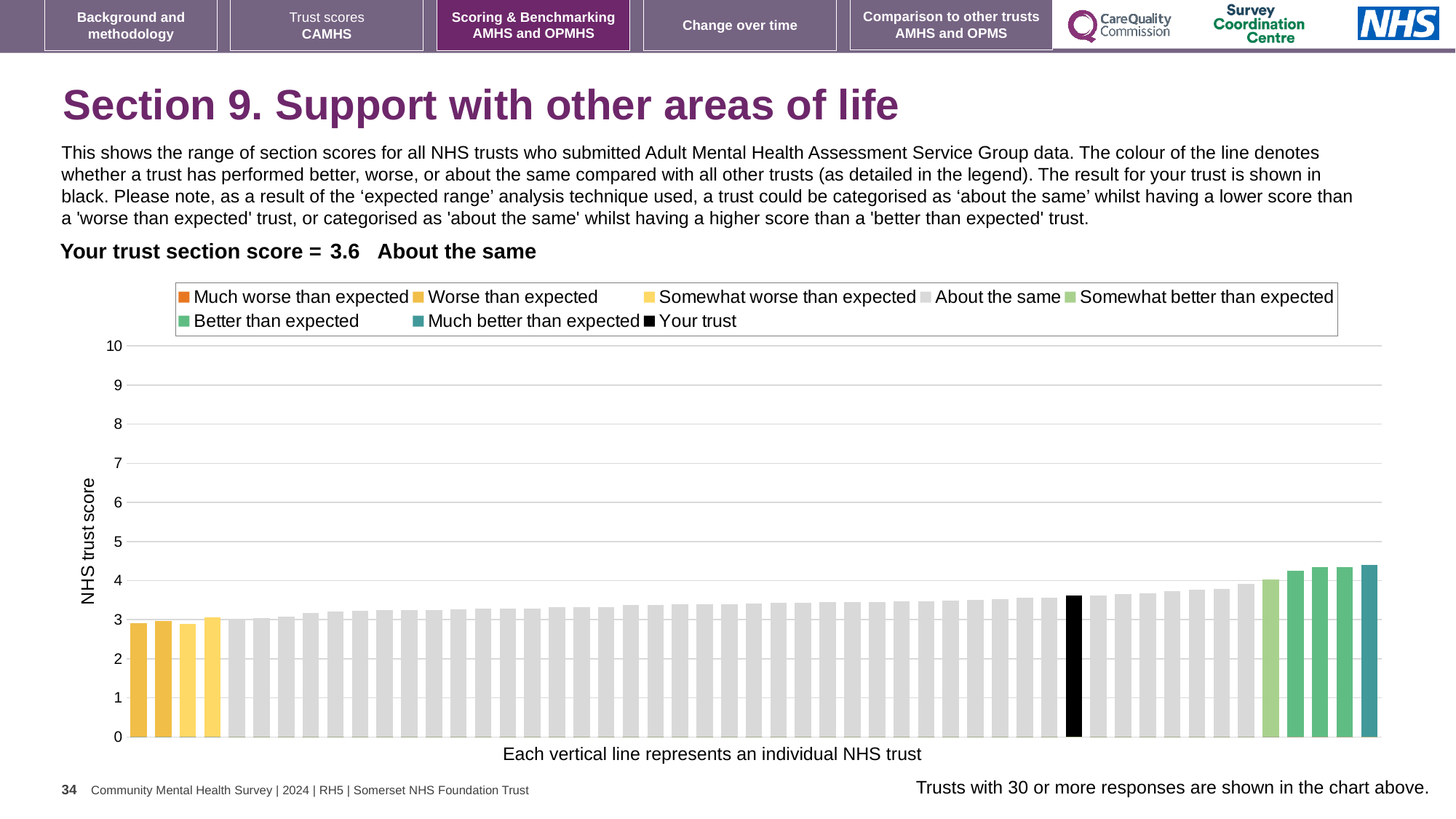
Do the bar values rise or fall from left to right along the x axis? Rise Which is larger, the value of the black 'Your trust' bar or the value of the leftmost bar? The black 'Your trust' bar Is the value of the tallest bar in the chart greater or less than 5? less Is the value of the black 'Your trust' bar greater or less than 3? greater What kind of chart is shown on the slide? Bar chart How many entries does the chart legend list? 8 What is the section score for your trust? 3.6 What colour is the bar representing your trust? Black Is the value of the leftmost bar in the chart greater or less than 2? greater What is the label on the vertical axis of the chart? NHS trust score Which legend category does the tallest bar in the chart belong to? Much better than expected